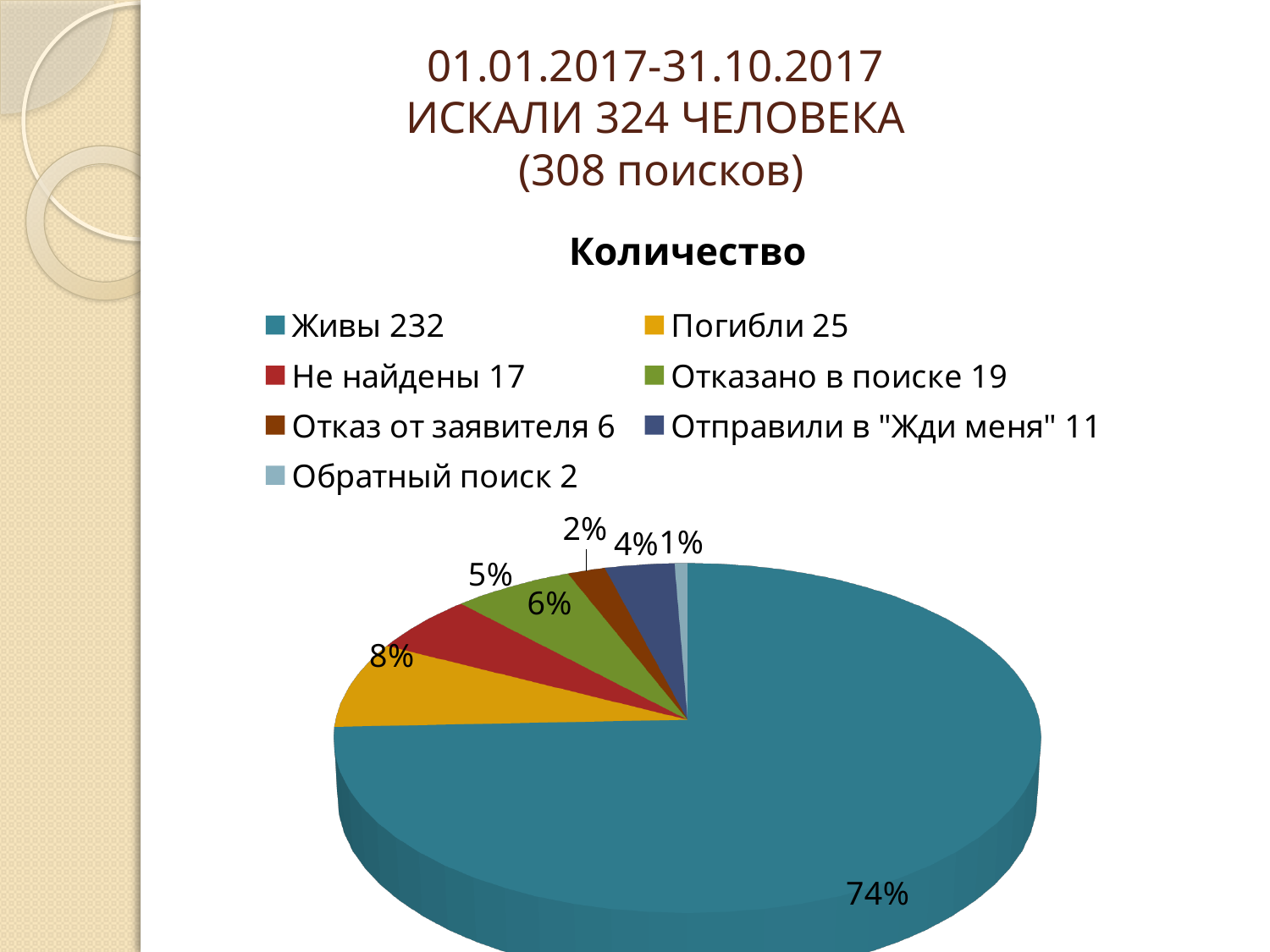
How many categories does the legend of the pie chart list? 7 Which category has the smallest slice of the pie? Обратный поиск What share of the pie does the "Живы" slice represent? 74% What is the difference between the counts for "Погибли" and "Не найдены"? 8 Which is larger, the count for "Отказано в поиске" or the count for "Отказ от заявителя"? Отказано в поиске What share of the pie does the "Погибли" slice represent? 8% What count is given for "Отправили в "Жди меня"" in the legend? 11 What kind of chart is shown on the slide? pie chart Which category has the largest slice of the pie? Живы What is the title of the chart? Количество What count is given for "Не найдены" in the legend? 17 What share of the pie does the "Отказано в поиске" slice represent? 6%